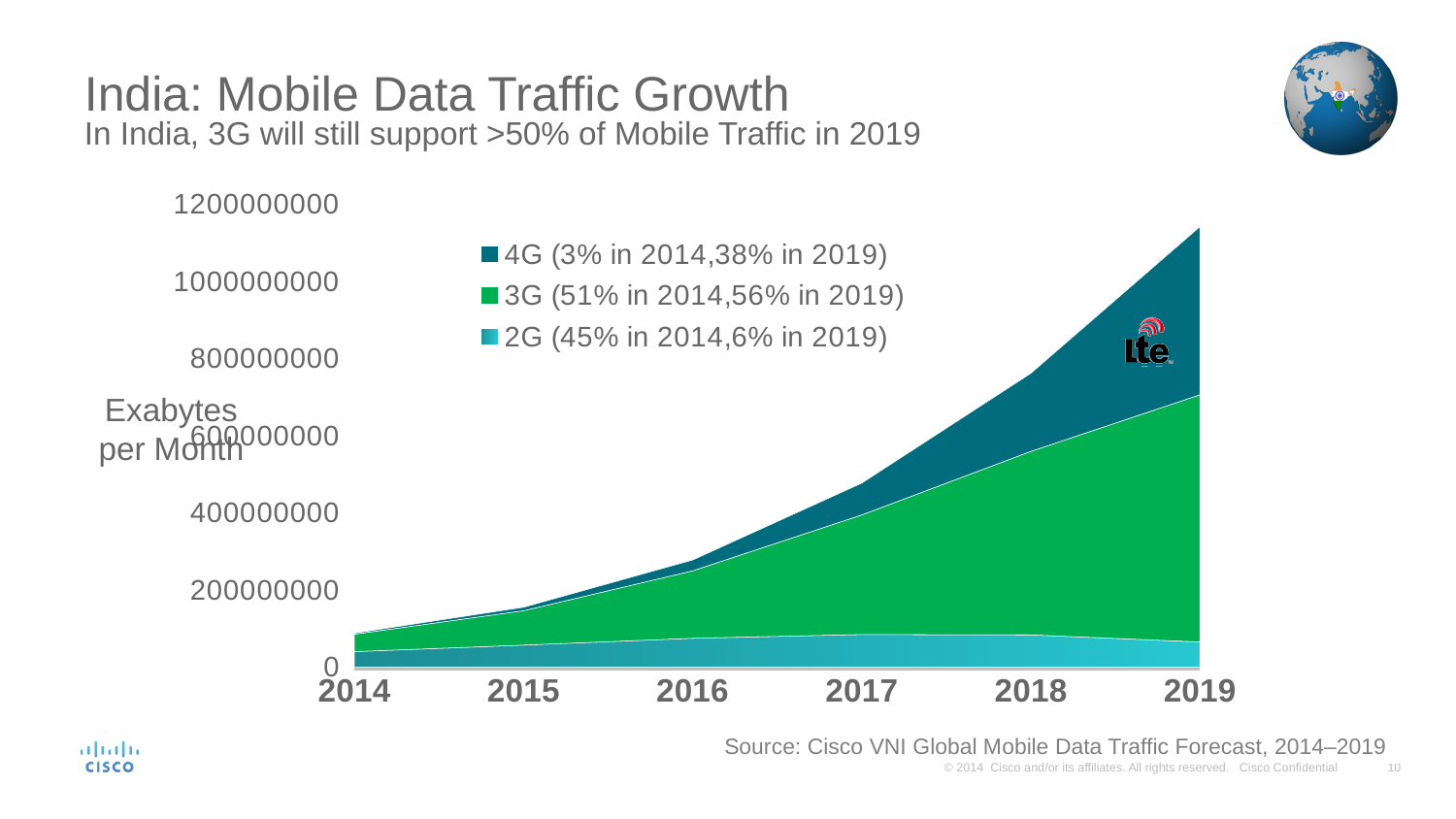
Is the total mobile data traffic in 2019 greater or less than 1000000000? greater What unit is shown on the y axis label? Exabytes per Month In 2019, which series accounts for the largest share of traffic, 3G or 4G? 3G How many series does the legend list? 3 Which year has the highest total mobile data traffic? 2019 What kind of chart is shown on the slide? Stacked area chart Which year has the lowest total mobile data traffic? 2014 Is the total mobile data traffic in 2015 greater or less than 200000000? less According to the legend, what share of mobile traffic does 4G account for in 2019? 38% How many years are shown along the x axis? 6 Does total mobile data traffic rise or fall from 2014 to 2019? Rises Is the total mobile data traffic in 2017 greater or less than 400000000? greater